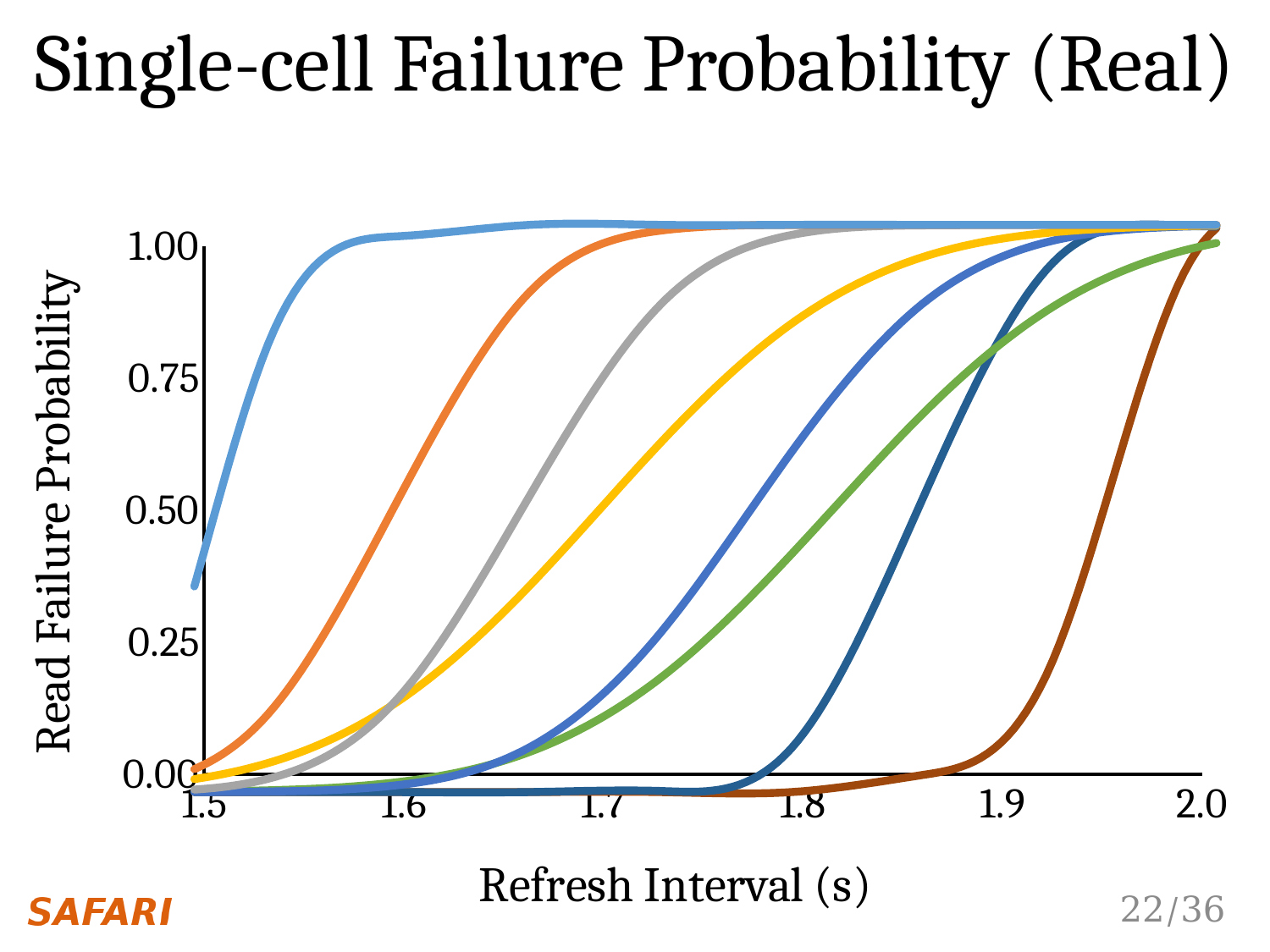
At a refresh interval of 1.6 s, which line has the higher read failure probability, the light blue line or the brown line? light blue line Is the value of the green line at a refresh interval of 1.9 s greater or less than 0.50? greater What is the label of the x axis? Refresh Interval (s) What kind of chart is shown on the slide? line chart Is the value of the dark blue line at a refresh interval of 1.8 s greater or less than 0.25? less How many lines are plotted on the chart? 8 Do the plotted lines rise or fall as the refresh interval increases? rise Is the value of the light blue line at a refresh interval of 1.6 s greater or less than 0.75? greater What is the title of the chart on the slide? Single-cell Failure Probability (Real)